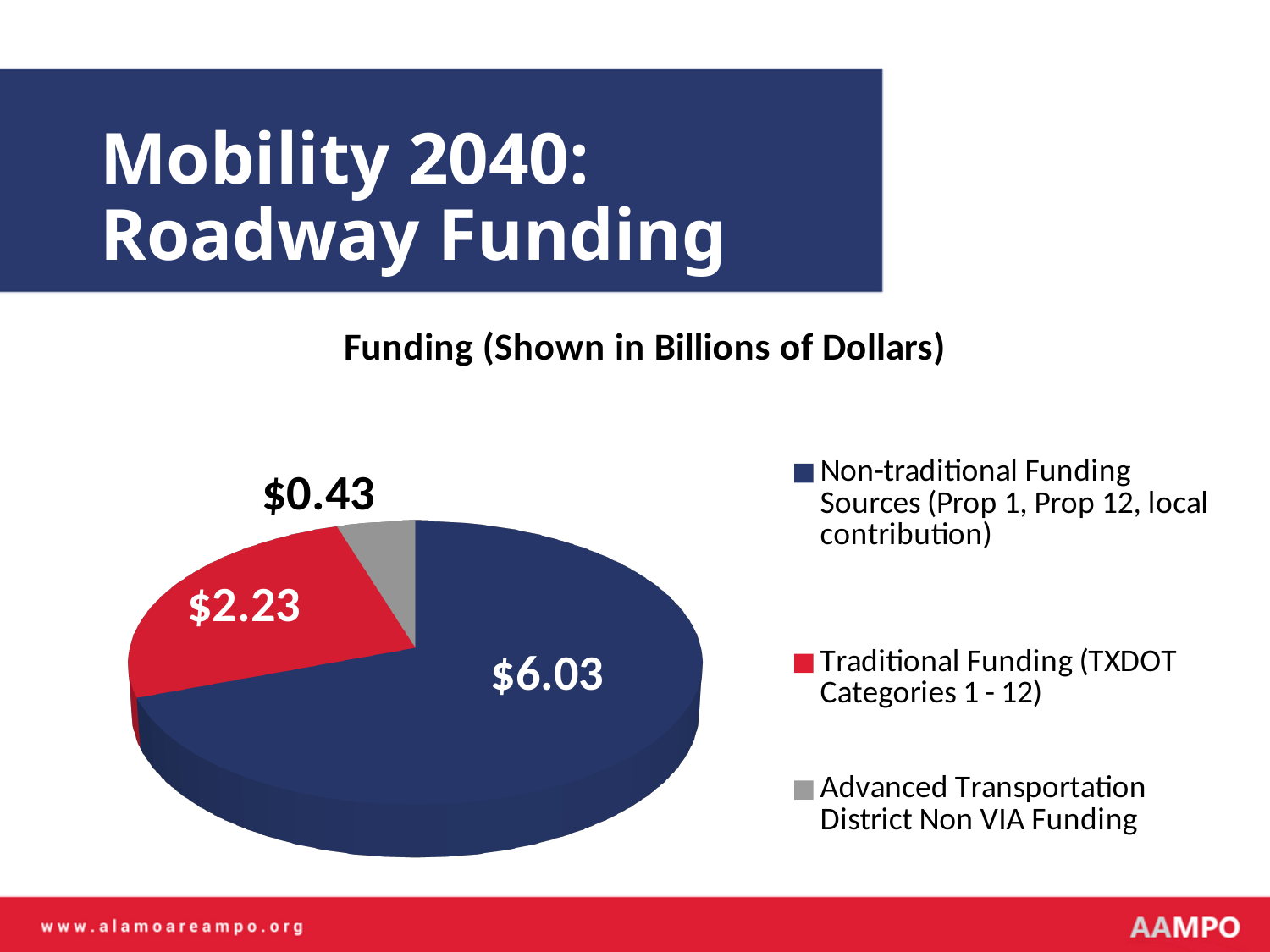
Which funding category has the smallest slice of the pie? Advanced Transportation District Non VIA Funding What is the value for Non-traditional Funding Sources (Prop 1, Prop 12, local contribution)? $6.03 What is the value for Advanced Transportation District Non VIA Funding? $0.43 What is the difference between Non-traditional Funding Sources and Traditional Funding? $3.80 How many slices does the pie chart have? 3 What colour is the slice for Traditional Funding (TXDOT Categories 1 - 12)? Red Which is larger, Traditional Funding (TXDOT Categories 1 - 12) or Advanced Transportation District Non VIA Funding? Traditional Funding (TXDOT Categories 1 - 12) What type of chart is shown on the slide? Pie chart What is the title of the chart? Funding (Shown in Billions of Dollars) What is the difference between Traditional Funding and Advanced Transportation District Non VIA Funding? $1.80 Which funding category has the largest slice of the pie? Non-traditional Funding Sources (Prop 1, Prop 12, local contribution) What is the value for Traditional Funding (TXDOT Categories 1 - 12)? $2.23